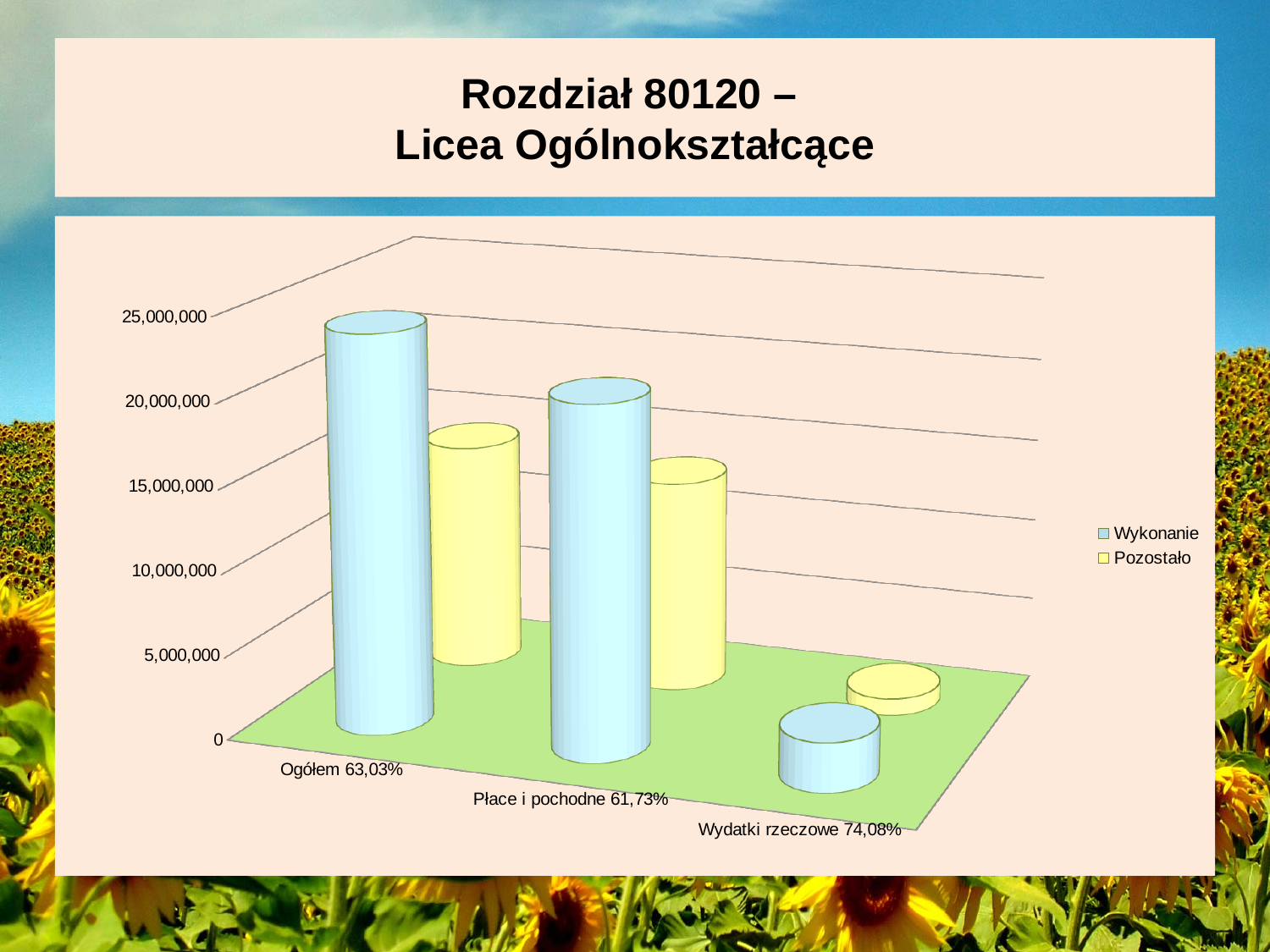
What percentage is shown in the category label for Wydatki rzeczowe? 74,08% Which category has the lowest Wykonanie value? Wydatki rzeczowe 74,08% For Ogółem, which is larger: Wykonanie or Pozostało? Wykonanie Which series is shown in yellow in the chart legend? Pozostało Is the Pozostało value for Płace i pochodne greater or less than 20,000,000? less How many series does the chart legend list? 2 What kind of chart is shown on the slide? bar chart Which category has the highest Wykonanie value? Ogółem 63,03% For Płace i pochodne, which is larger: Wykonanie or Pozostało? Wykonanie How many categories are shown on the x axis of the chart? 3 Is the Wykonanie value for Wydatki rzeczowe greater or less than 5,000,000? less Is the Wykonanie value for Ogółem greater or less than 15,000,000? greater